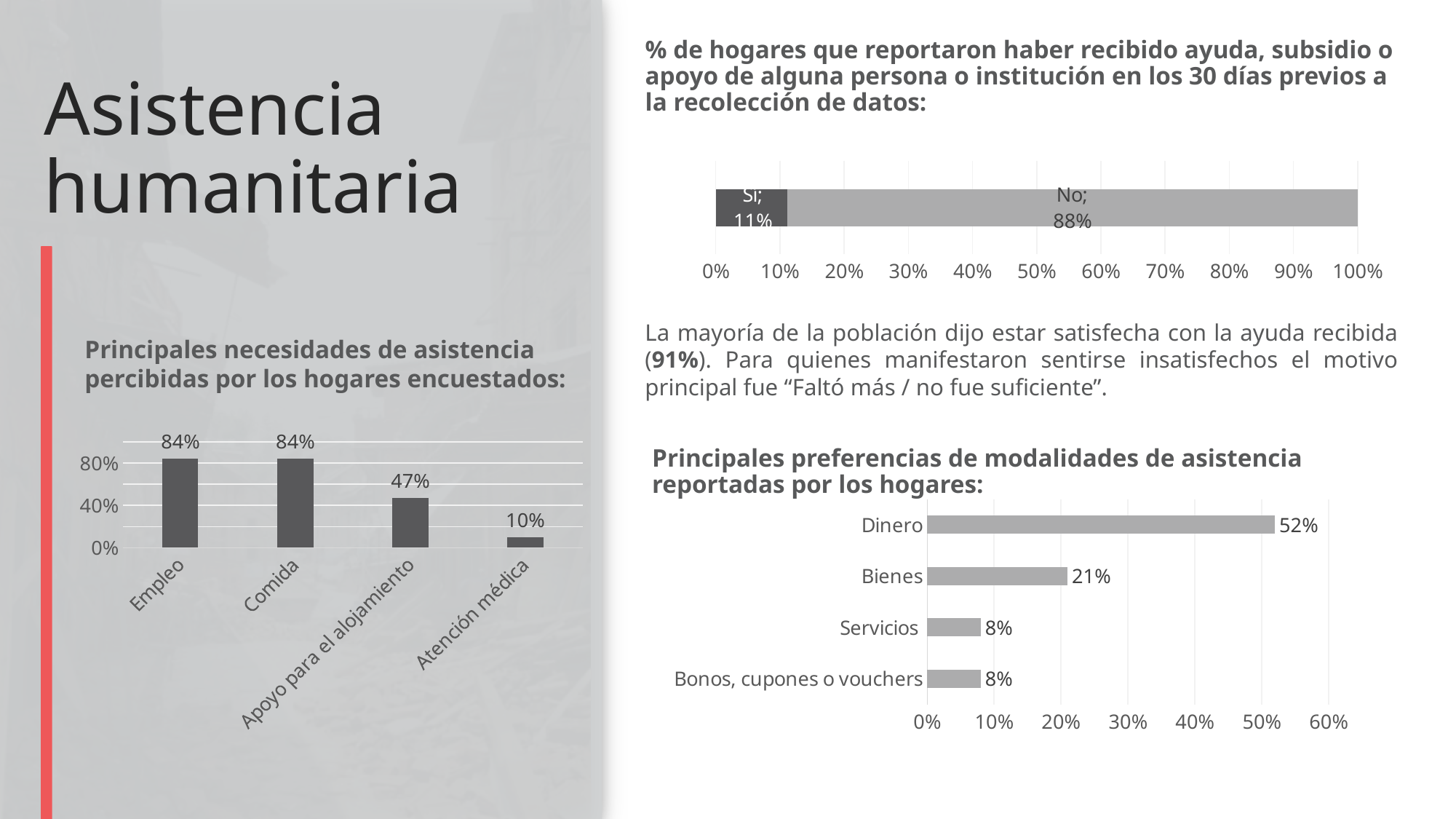
In the chart 'Principales necesidades de asistencia percibidas por los hogares encuestados', what is the value for Apoyo para el alojamiento? 47% In the chart '% de hogares que reportaron haber recibido ayuda, subsidio o apoyo de alguna persona o institución en los 30 días previos a la recolección de datos', what is the value for Sí? 11% In the chart 'Principales preferencias de modalidades de asistencia reportadas por los hogares', which category has the highest value? Dinero In the chart 'Principales necesidades de asistencia percibidas por los hogares encuestados', which category has the lowest value? Atención médica In the chart '% de hogares que reportaron haber recibido ayuda, subsidio o apoyo de alguna persona o institución en los 30 días previos a la recolección de datos', what is the value for No? 88% In the chart 'Principales necesidades de asistencia percibidas por los hogares encuestados', what is the value for Comida? 84% What kind of chart is 'Principales preferencias de modalidades de asistencia reportadas por los hogares'? Bar chart In the chart 'Principales preferencias de modalidades de asistencia reportadas por los hogares', what is the difference between Dinero and Bienes? 31% How many categories are shown in the chart 'Principales necesidades de asistencia percibidas por los hogares encuestados'? 4 In the chart 'Principales necesidades de asistencia percibidas por los hogares encuestados', what is the difference between Empleo and Atención médica? 74% In the chart 'Principales preferencias de modalidades de asistencia reportadas por los hogares', which is larger, Bienes or Servicios? Bienes In the chart 'Principales preferencias de modalidades de asistencia reportadas por los hogares', what is the value for Dinero? 52%